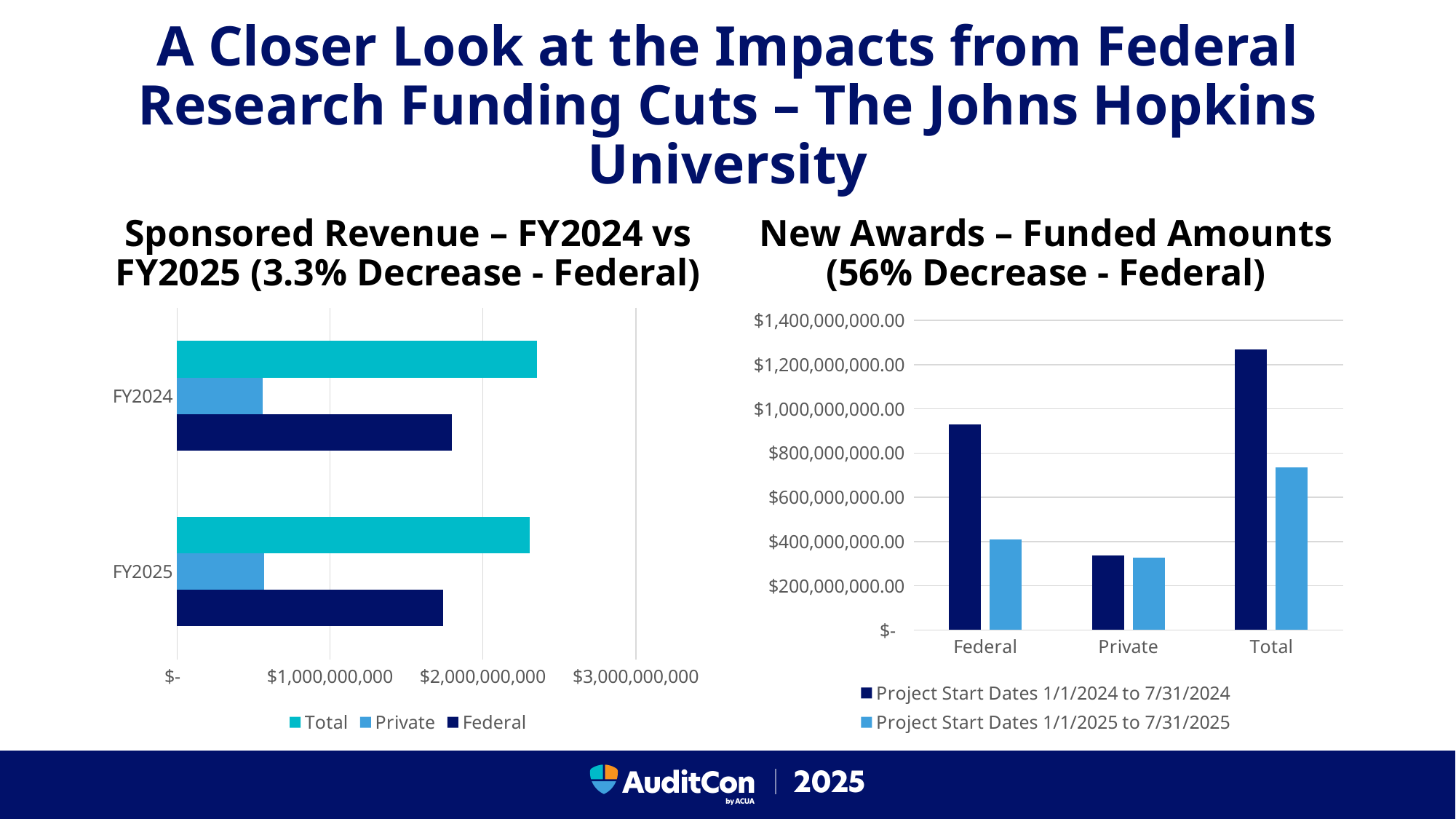
How many categories are shown on the x axis of the right chart ('New Awards – Funded Amounts')? 3 What kind of chart is the 'Sponsored Revenue – FY2024 vs FY2025' chart on the left? Bar chart In the right chart ('New Awards – Funded Amounts'), which bar is the highest? Total, Project Start Dates 1/1/2024 to 7/31/2024 How many series does the legend of the right chart ('New Awards – Funded Amounts') list? 2 How many series does the legend of the left chart ('Sponsored Revenue') list? 3 In the left chart ('Sponsored Revenue'), is the Federal value for FY2025 greater or less than $2,000,000,000? less In the left chart ('Sponsored Revenue'), which series has the smallest bar for FY2025? Private In the right chart ('New Awards – Funded Amounts'), is the Federal value for Project Start Dates 1/1/2024 to 7/31/2024 greater or less than $800,000,000.00? greater In the left chart ('Sponsored Revenue'), is the Total value for FY2024 greater or less than $2,000,000,000? greater In the right chart ('New Awards – Funded Amounts'), which is larger for Federal: Project Start Dates 1/1/2024 to 7/31/2024 or Project Start Dates 1/1/2025 to 7/31/2025? Project Start Dates 1/1/2024 to 7/31/2024